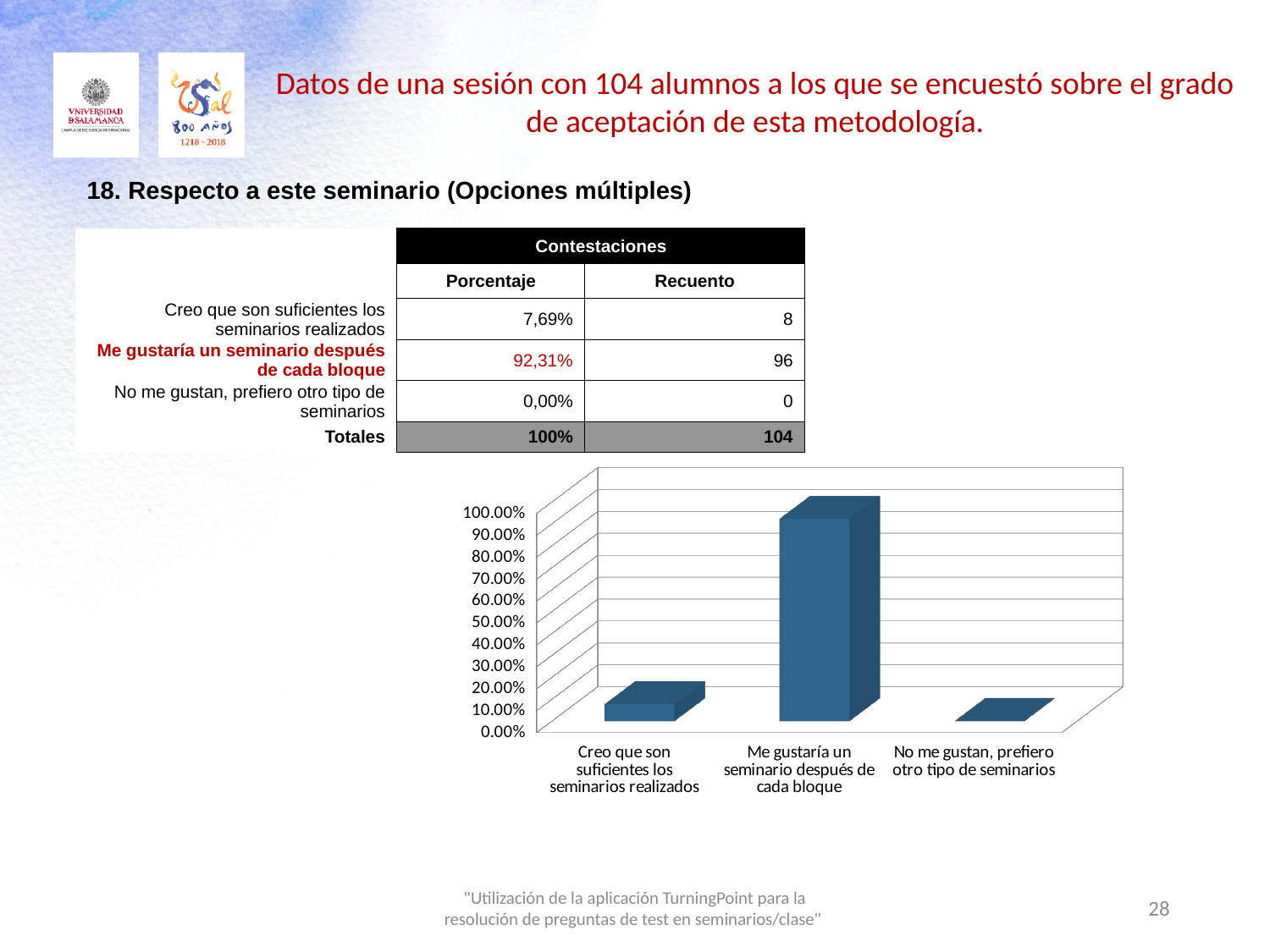
According to the table, what is the difference in percentage between 'Me gustaría un seminario después de cada bloque' and 'Creo que son suficientes los seminarios realizados'? 84,62% Is the bar for 'Me gustaría un seminario después de cada bloque' greater or less than 90.00%? greater Which category has the lowest bar in the chart? No me gustan, prefiero otro tipo de seminarios What kind of chart is shown on the slide? bar chart What is the highest tick value shown on the vertical axis of the chart? 100.00% Is the bar for 'Creo que son suficientes los seminarios realizados' greater or less than 20.00%? less How many categories are plotted on the x axis of the chart? 3 Which is larger, the bar for 'Creo que son suficientes los seminarios realizados' or the bar for 'No me gustan, prefiero otro tipo de seminarios'? Creo que son suficientes los seminarios realizados What is the total Recuento shown in the Totales row of the table? 104 According to the table, what percentage corresponds to 'Me gustaría un seminario después de cada bloque'? 92,31% Which category has the highest bar in the chart? Me gustaría un seminario después de cada bloque According to the table, what is the Recuento for 'Creo que son suficientes los seminarios realizados'? 8